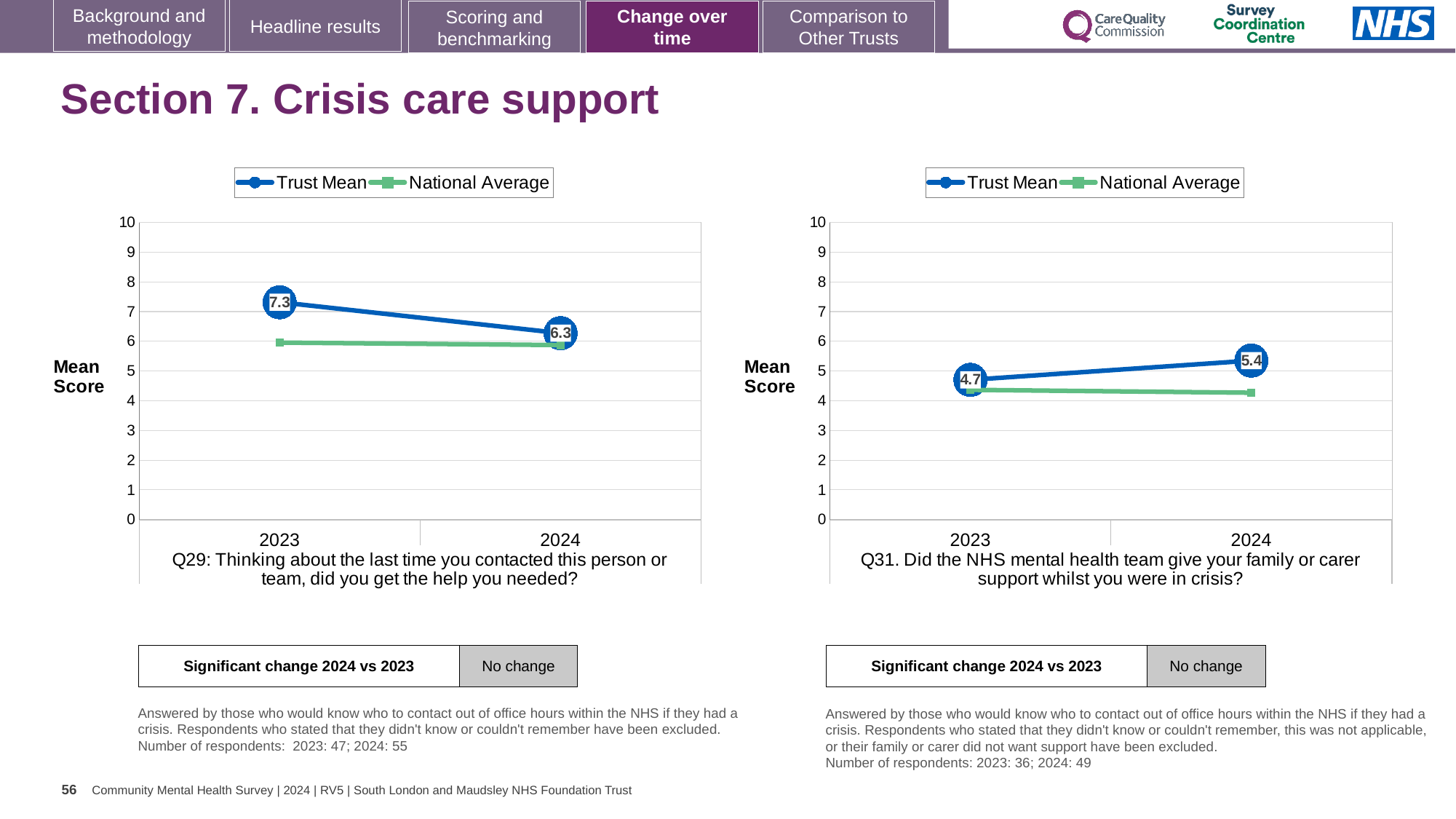
In the Q29 chart (left), is the National Average for 2023 greater or less than 7? less In the Q31 chart (right), is the Trust Mean for 2024 greater or less than the National Average for 2024? greater In the Q31 chart (right), by how much did the Trust Mean rise from 2023 to 2024? 0.7 How many series does the legend of the Q31 chart (right) list? 2 What kind of chart is the Q29 chart (left)? line chart In the Q29 chart (left), what is the Trust Mean score for 2023? 7.3 In the Q29 chart (left), what is the Trust Mean score for 2024? 6.3 In the Q31 chart (right), what is the Trust Mean score for 2024? 5.4 In the Q31 chart (right), what is the Trust Mean score for 2023? 4.7 In the Q29 chart (left), does the Trust Mean rise or fall from 2023 to 2024? fall In the Q31 chart (right), does the Trust Mean rise or fall from 2023 to 2024? rise In the Q29 chart (left), by how much did the Trust Mean fall from 2023 to 2024? 1.0